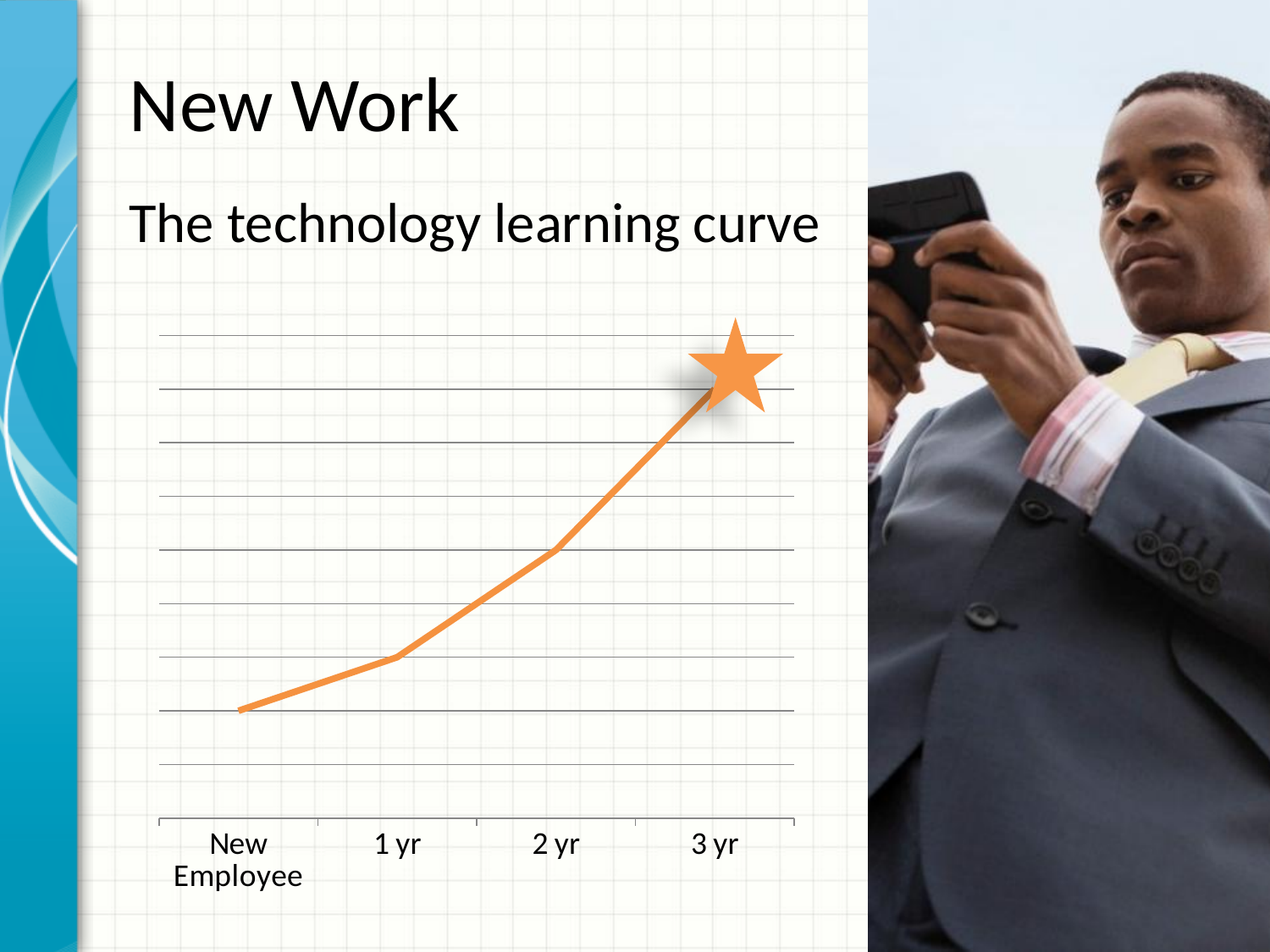
Which has the larger value in the chart, New Employee or 3 yr? 3 yr How many categories are shown on the x axis of the chart? 4 What is the first category on the x axis of the chart? New Employee What kind of chart is shown on the slide? line chart What colour is the line in the chart? orange Which has the larger value in the chart, 1 yr or 2 yr? 2 yr Which category has the highest value in the chart? 3 yr Which category has the lowest value in the chart? New Employee Which has the smaller value in the chart, 1 yr or 3 yr? 1 yr Do the values in the chart rise or fall from New Employee to 3 yr? rise